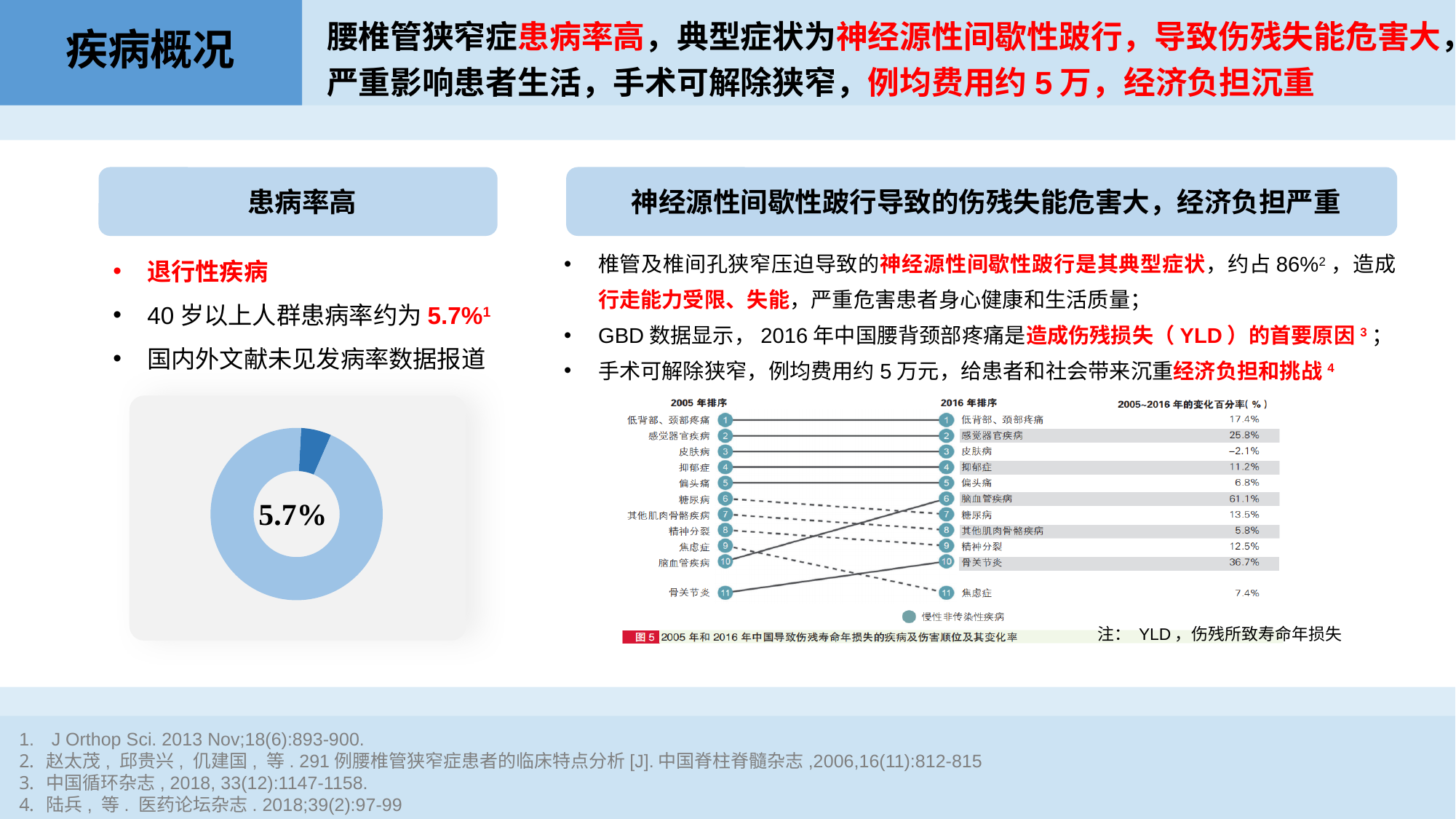
In the ranking chart on the right (图5), what is the 2005 rank of 骨关节炎? 11 In the ranking chart on the right (图5), what is the difference between the change percentages of 脑血管疾病 and 骨关节炎? 24.4 percentage points In the ranking chart on the right (图5), what is the 2005~2016 change percentage for 糖尿病? 13.5% In the ranking chart on the right (图5), what is the 2005~2016 change percentage for 低背部、颈部疼痛? 17.4% What kind of chart is the chart on the left of the slide? Pie (donut) chart On the donut chart on the left, what value is printed in the centre? 5.7% In the ranking chart on the right (图5), what is the 2016 rank of 焦虑症? 11 In the ranking chart on the right (图5), which condition has the lowest 2005~2016 change percentage? 皮肤病 In the ranking chart on the right (图5), what is the 2016 rank of 骨关节炎? 10 In the ranking chart on the right (图5), which has the larger change percentage, 感觉器官疾病 or 抑郁症? 感觉器官疾病 In the ranking chart on the right (图5), which condition has the largest 2005~2016 change percentage? 脑血管疾病 How many conditions are ranked in the chart on the right (图5)? 11